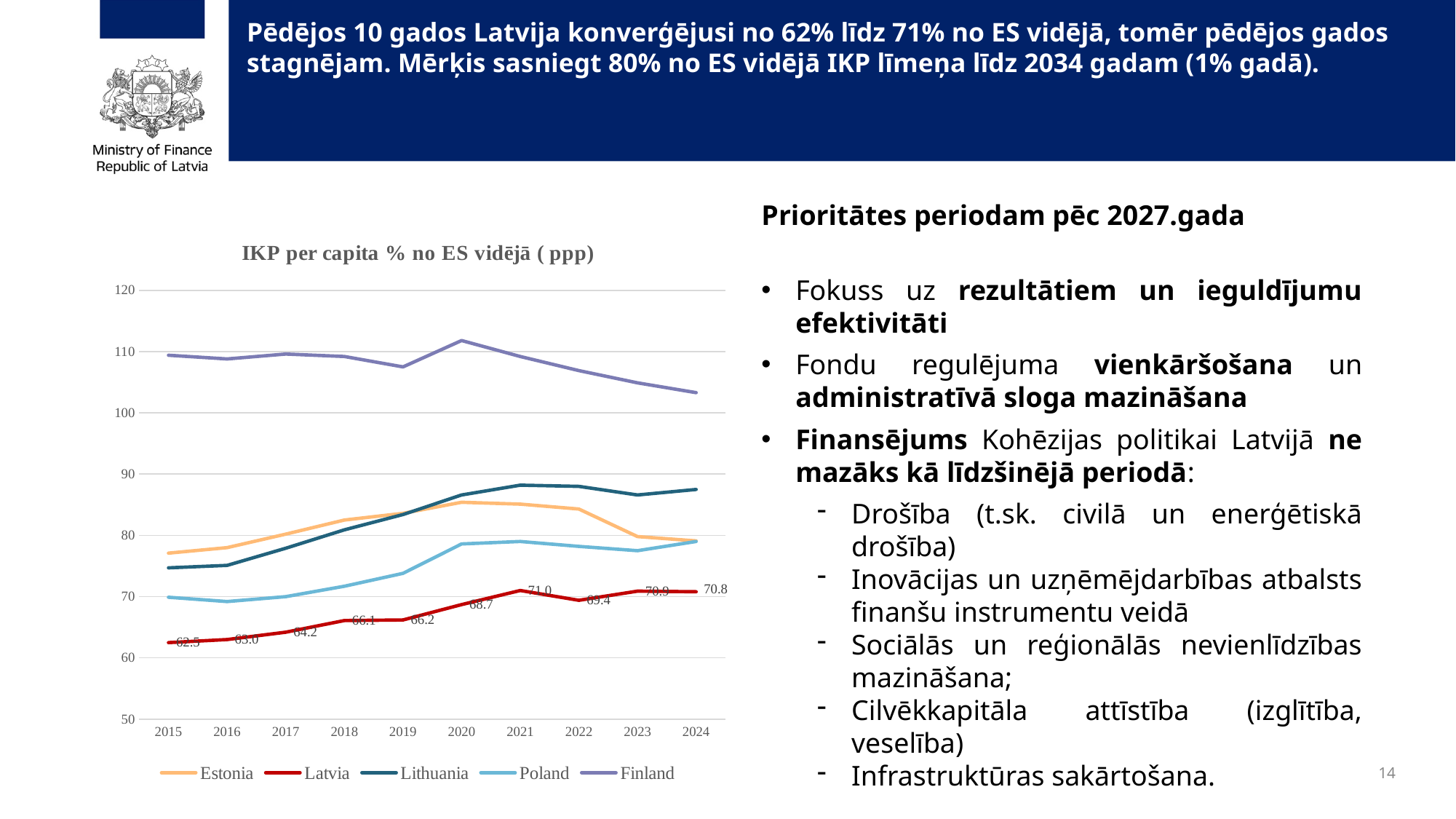
What type of chart is shown on the slide? line chart What is the value for Latvia in 2024? 70.8 By how much did Latvia's value increase from 2015 to 2024? 8.3 How many years are shown on the x axis of the chart? 10 What is the title of the chart? IKP per capita % no ES vidējā ( ppp) Is the value for Finland in 2020 greater or less than 110? greater What is the value for Latvia in 2021? 71.0 What is the value for Latvia in 2015? 62.5 Which is larger in 2024, the value for Estonia or the value for Lithuania? Lithuania How many series does the chart legend list? 5 Which country has the highest value in 2024? Finland Which country has the lowest value in 2024? Latvia